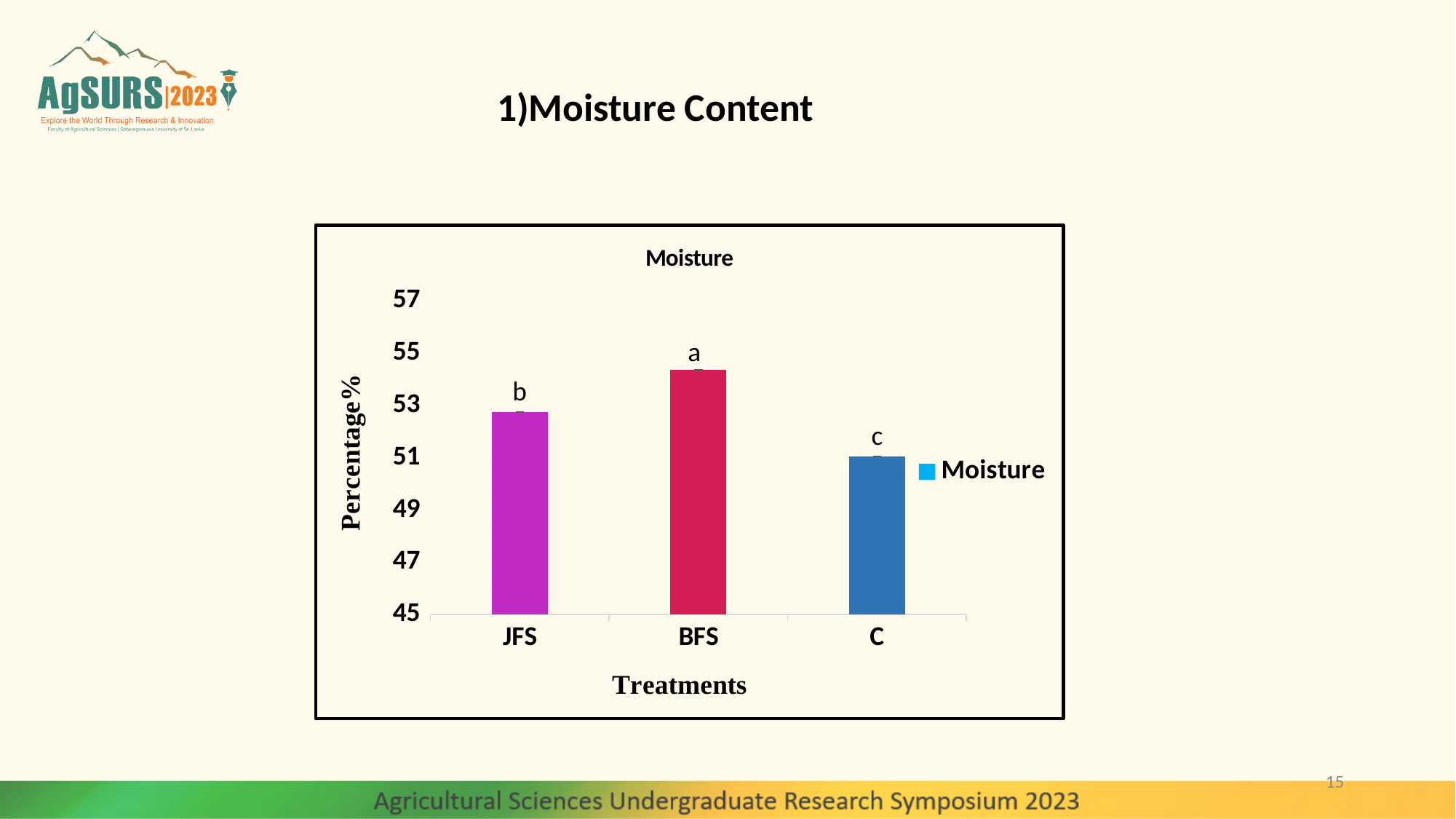
What is the label of the y axis on the Moisture chart? Percentage% How many series does the legend of the Moisture chart list? 1 What is the label of the x axis on the Moisture chart? Treatments Which treatment has the lowest moisture percentage? C Which has a higher moisture percentage, JFS or C? JFS Which has a higher moisture percentage, JFS or BFS? BFS Is the moisture value for BFS greater or less than 53? greater Is the moisture value for JFS greater or less than 51? greater Which treatment has the highest moisture percentage? BFS How many treatments are plotted on the x axis of the Moisture chart? 3 Is the moisture value for C greater or less than 53? less What type of chart is shown on the slide? bar chart